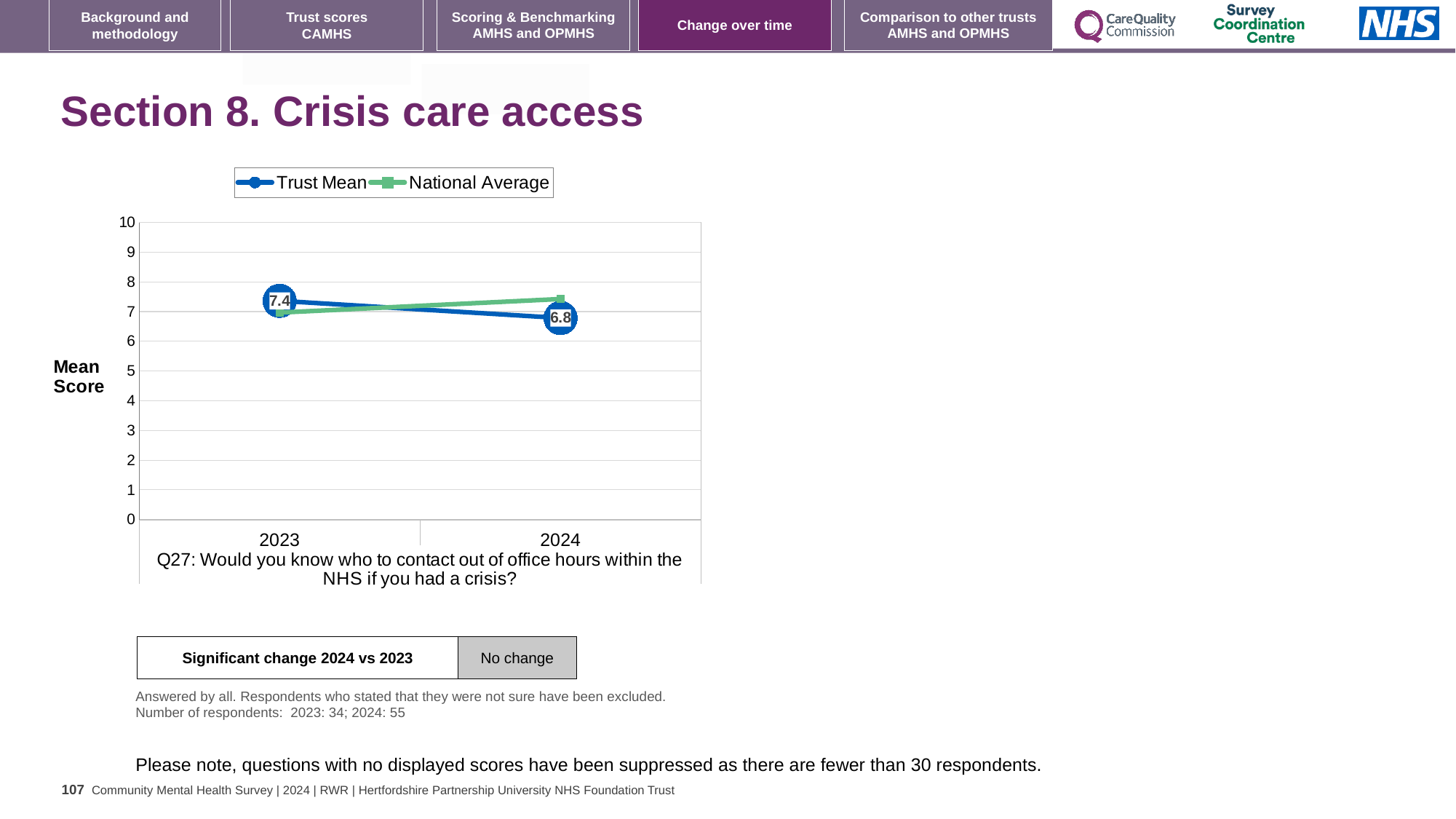
Does the Trust Mean rise or fall from 2023 to 2024? fall Is the National Average value for 2023 greater or less than 8? less How many series does the legend list? 2 In 2024, which series is higher, Trust Mean or National Average? National Average What kind of chart is shown on the slide? line chart What is the label on the y axis of the chart? Mean Score What is the Trust Mean score for 2023? 7.4 Is the National Average value for 2024 greater or less than 5? greater What is the Trust Mean score for 2024? 6.8 How many years are shown on the x axis of the chart? 2 By how much did the Trust Mean score change from 2023 to 2024? 0.6 Which year has the higher Trust Mean score, 2023 or 2024? 2023